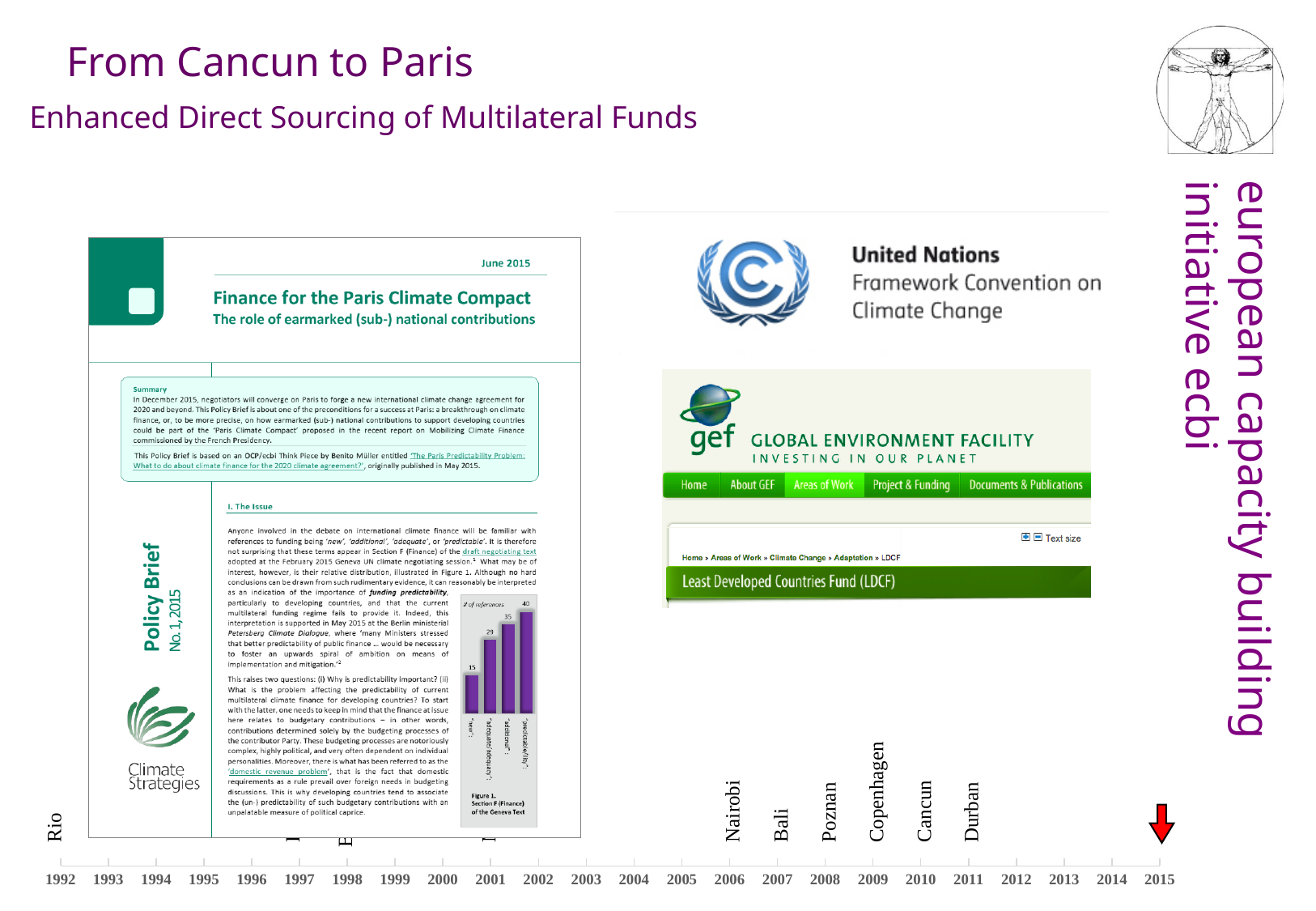
In the Figure 1 bar chart inside the policy brief, what is the difference between the highest bar (40) and the lowest bar (15)? 25 What kind of chart is Figure 1 inside the policy brief image on the left of the slide? bar chart In the Figure 1 bar chart inside the policy brief, what is the value of the bar labelled 'new'? 15 In the Figure 1 bar chart inside the policy brief, what is the value of the third bar from the left? 35 In the Figure 1 bar chart inside the policy brief, what is the highest value shown on a bar? 40 What colour are the bars in the Figure 1 bar chart inside the policy brief? purple In the Figure 1 bar chart inside the policy brief, what is the value of the second bar from the left? 29 In the Figure 1 bar chart inside the policy brief, how many bars are plotted? 4 What quantity does the Figure 1 bar chart inside the policy brief measure, according to its heading? # of references In the Figure 1 bar chart inside the policy brief, is the second bar (29) larger or smaller than the third bar (35)? smaller In the Figure 1 bar chart inside the policy brief, do the bar values rise or fall from left to right? rise In the Figure 1 bar chart inside the policy brief, what is the lowest value shown on a bar? 15